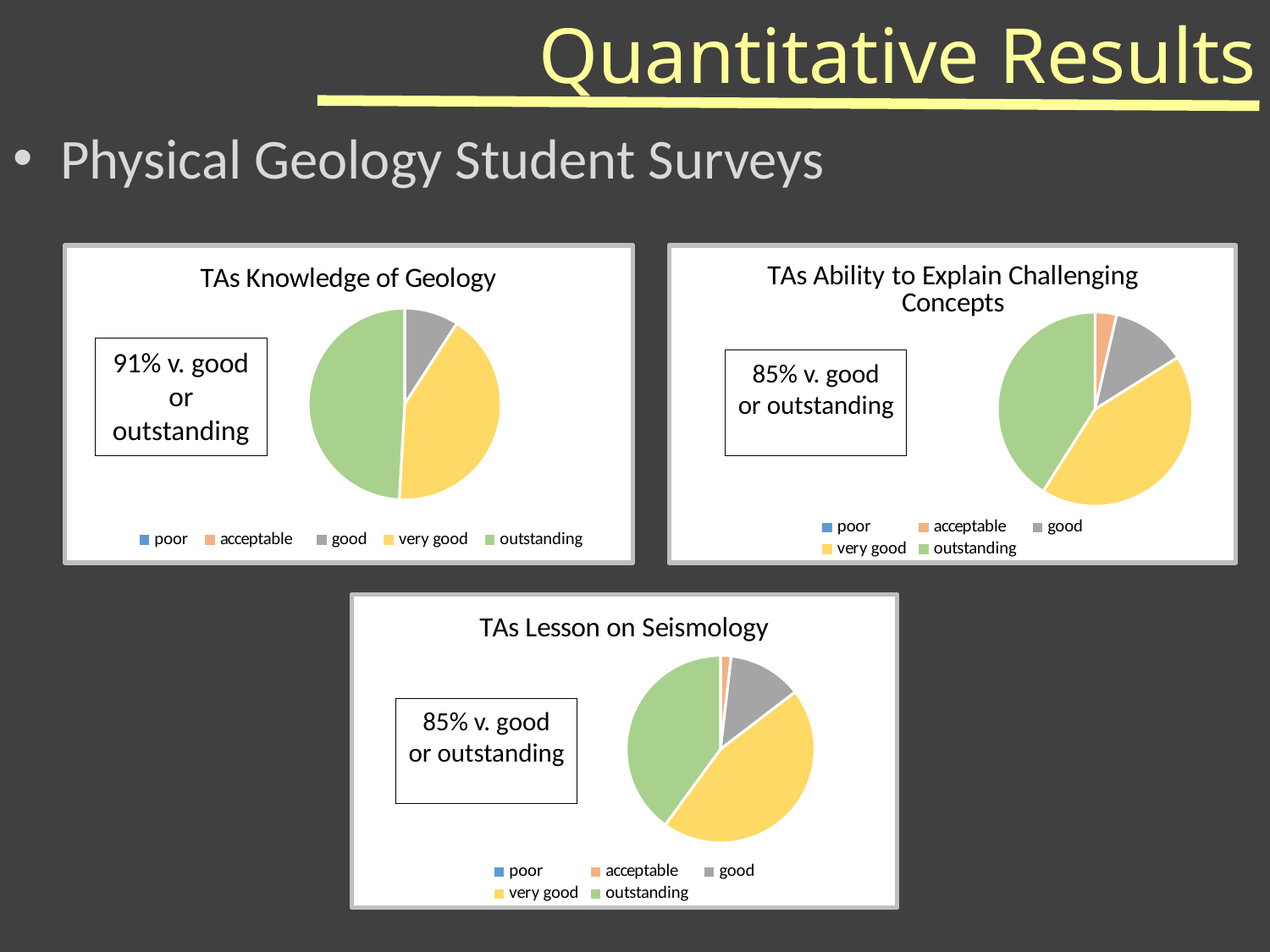
In the 'TAs Knowledge of Geology' chart, what percentage of responses were very good or outstanding, according to the text box? 91% How many categories does the legend of the 'TAs Knowledge of Geology' chart list? 5 In the 'TAs Lesson on Seismology' chart, which slice is larger: good or outstanding? outstanding In the 'TAs Knowledge of Geology' chart, which slice is larger: good or very good? very good In the 'TAs Lesson on Seismology' chart, what percentage of responses were very good or outstanding, according to the text box? 85% In the 'TAs Ability to Explain Challenging Concepts' chart, which visible category has the smallest slice? acceptable What colour represents the 'outstanding' category in the pie charts? green In the 'TAs Ability to Explain Challenging Concepts' chart, what percentage of responses were very good or outstanding, according to the text box? 85% How many pie charts are shown on the slide? 3 In the 'TAs Knowledge of Geology' chart, which category has the largest slice? outstanding In the 'TAs Lesson on Seismology' chart, which visible category has the smallest slice? acceptable What kind of chart is the 'TAs Knowledge of Geology' chart? pie chart